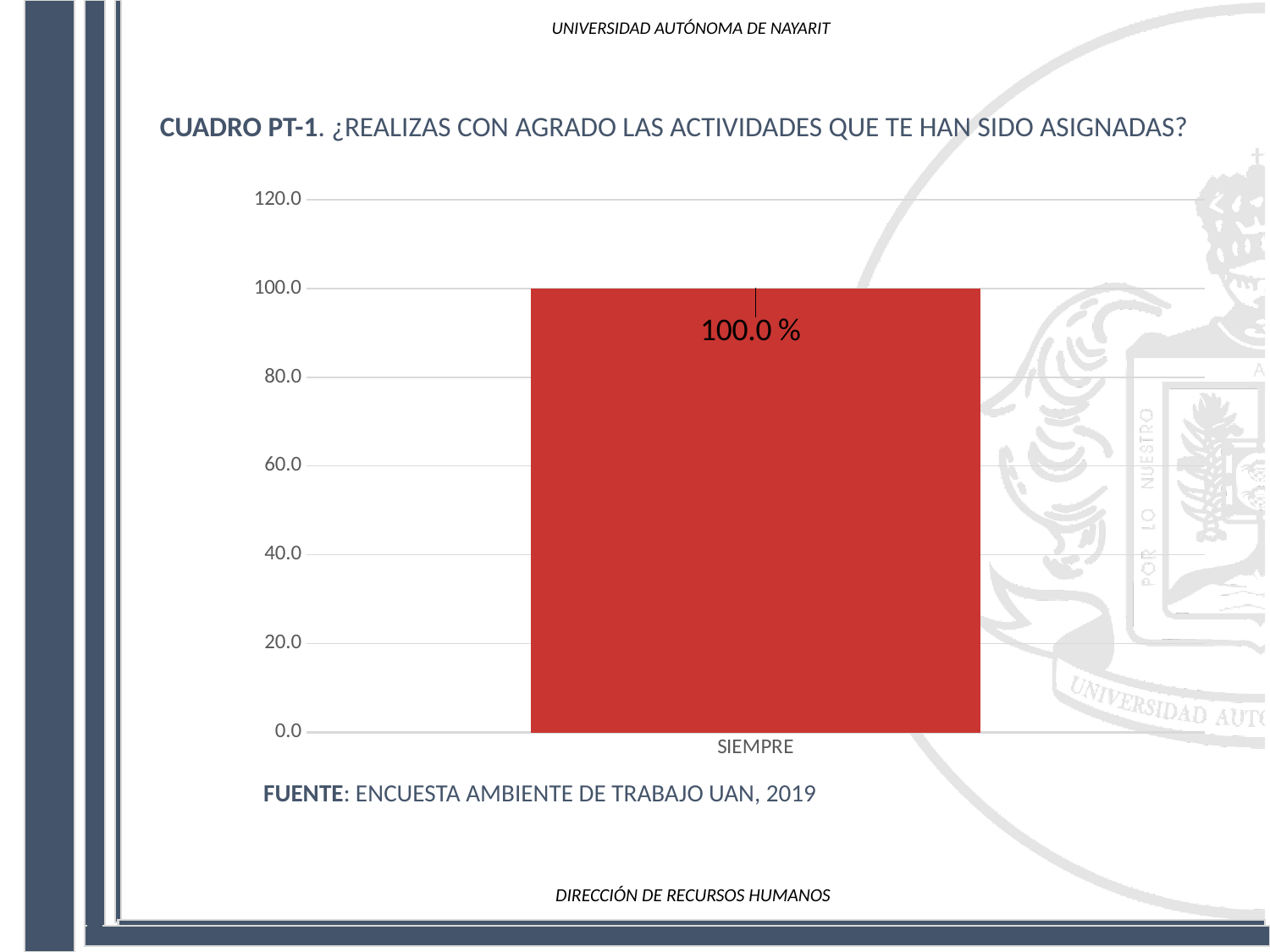
What kind of chart is shown on the slide? bar chart How many categories are plotted on the chart? 1 Is the value for SIEMPRE greater or less than 80.0? greater What is the label of the only category on the x axis? SIEMPRE What is the value shown for SIEMPRE? 100.0 % What is the highest value shown on the y axis? 120.0 Which category has the highest value on the chart? SIEMPRE